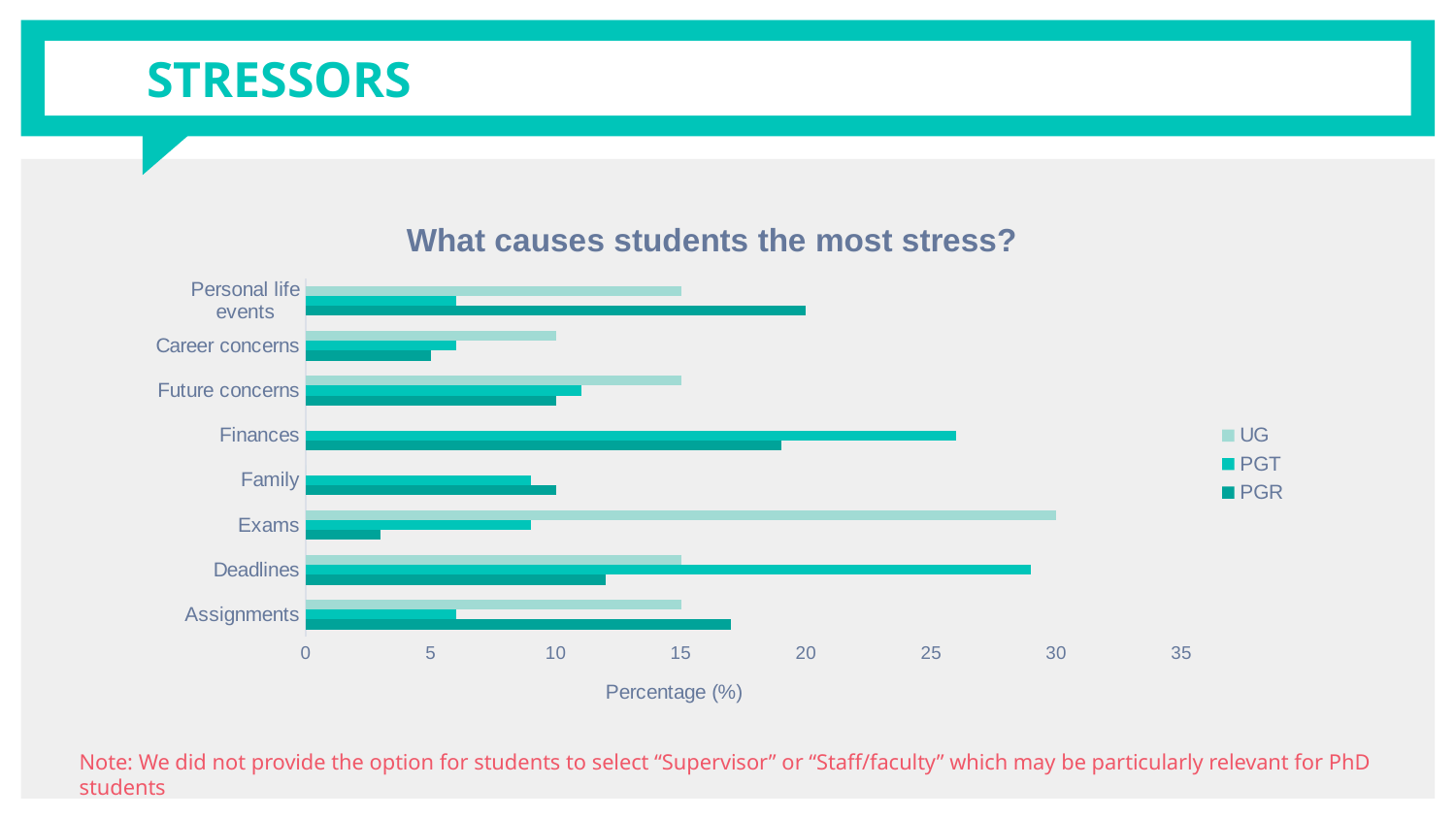
What is the title of the chart? What causes students the most stress? What kind of chart is shown on the slide? Bar chart Which category has the highest value for the PGT series? Deadlines Is the UG value for Finances greater or less than 25? less For Deadlines, which series has the larger value, PGT or PGR? PGT For Finances, which series has the larger value, UG or PGR? PGR How many stressor categories are shown on the chart? 8 Which category has the highest value for the UG series? Exams Is the PGT value for Exams greater or less than 5? greater How many series does the legend list? 3 Which category has the lowest value for the PGR series? Exams